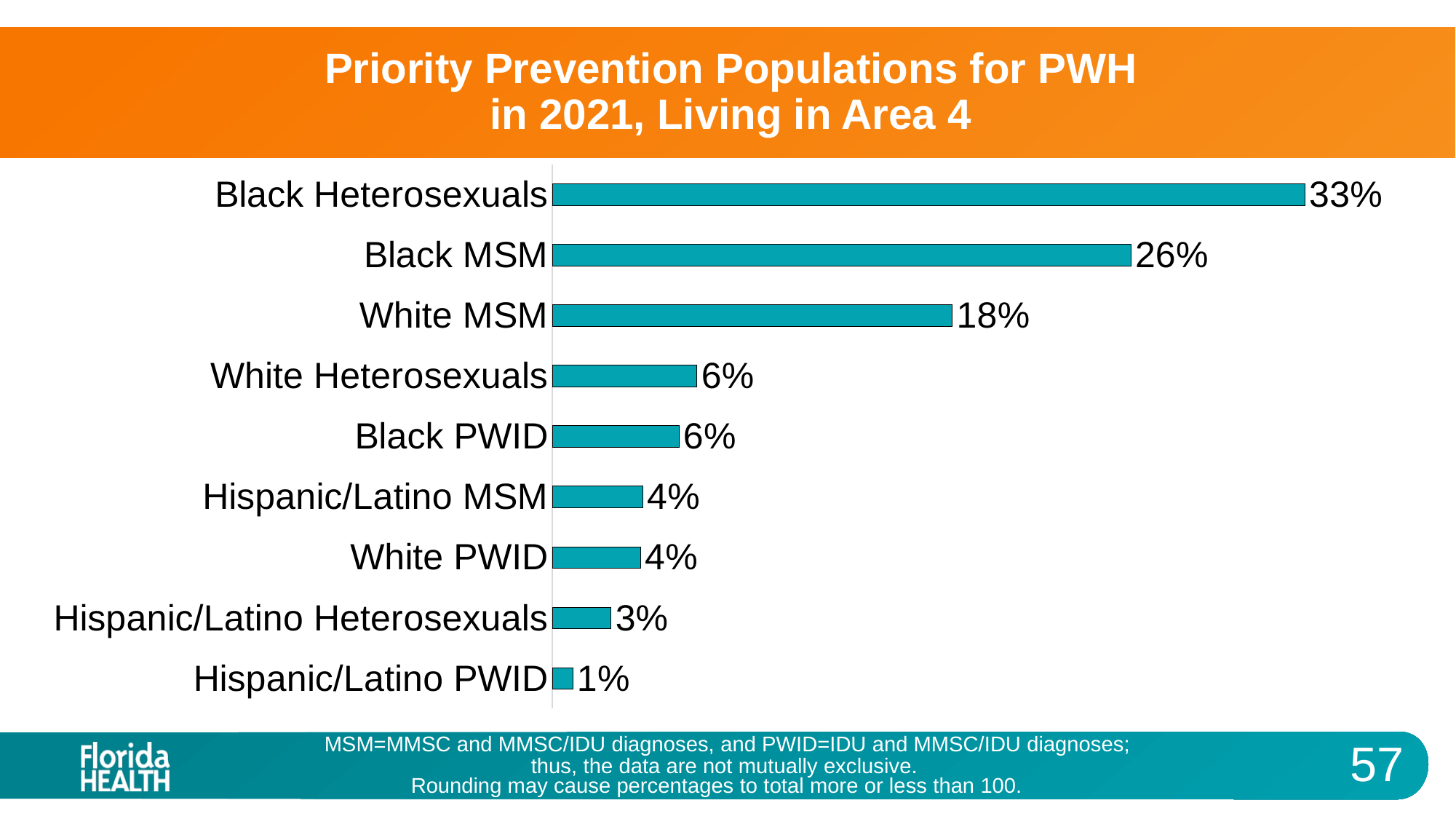
Which is larger, the percentage for Hispanic/Latino MSM or for Hispanic/Latino PWID? Hispanic/Latino MSM What percentage is shown for Black Heterosexuals? 33% Which population has the lowest percentage? Hispanic/Latino PWID What kind of chart is shown on the slide? Bar chart What is the difference between the percentages for Black Heterosexuals and Black MSM? 7% How many populations are shown in the chart? 9 What is the difference between the percentages for White MSM and White Heterosexuals? 12% What percentage is shown for Hispanic/Latino Heterosexuals? 3% What is the title of the chart? Priority Prevention Populations for PWH in 2021, Living in Area 4 Which is larger, the percentage for Black MSM or for White MSM? Black MSM Which population has the highest percentage? Black Heterosexuals What percentage is shown for White MSM? 18%